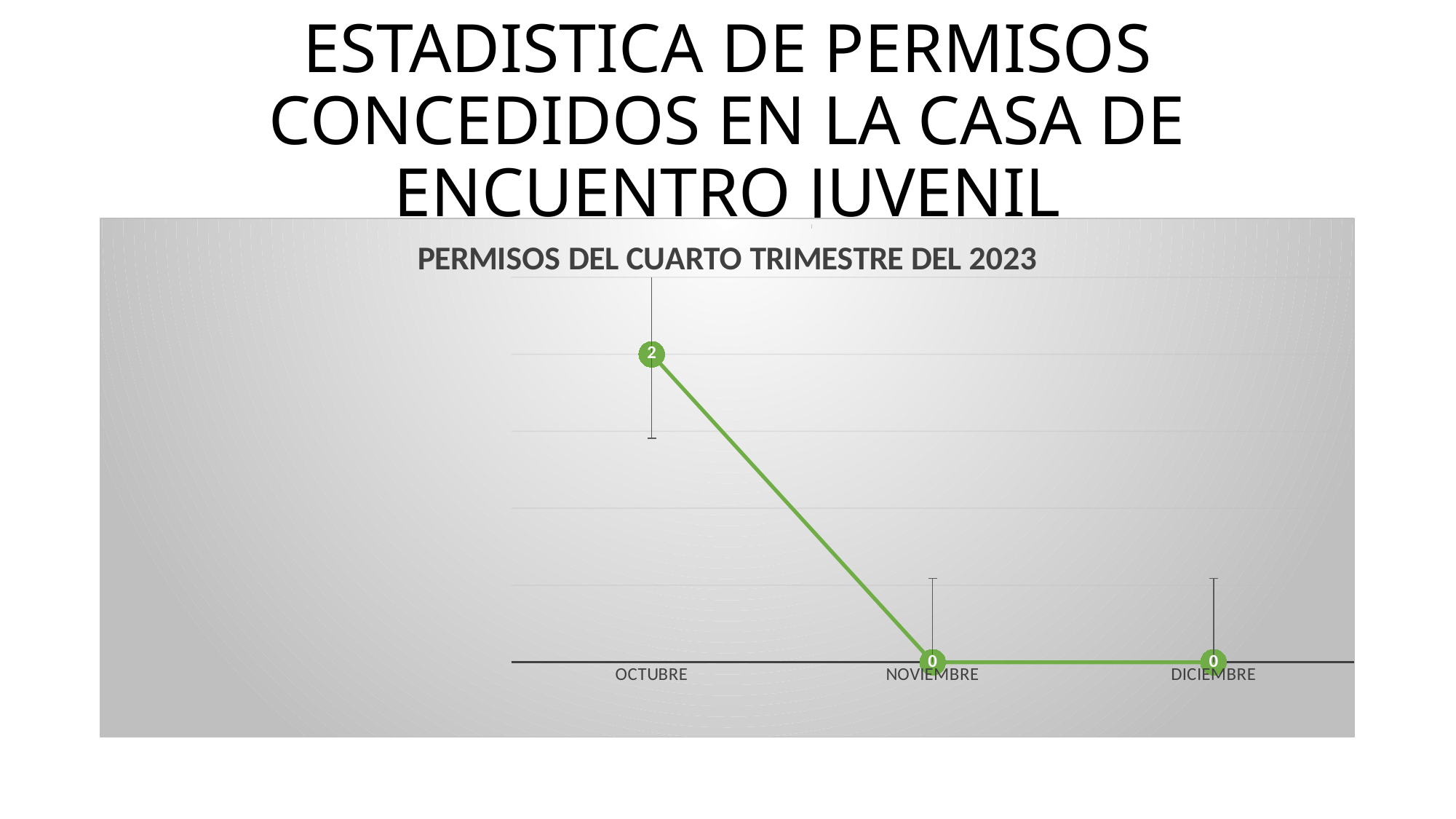
Which is larger, the value for OCTUBRE or the value for DICIEMBRE? OCTUBRE What is the value for NOVIEMBRE in the chart? 0 What kind of chart is shown on the slide? line chart What is the title of the chart? PERMISOS DEL CUARTO TRIMESTRE DEL 2023 What colour is the line in the chart? green Do the values rise or fall from OCTUBRE to DICIEMBRE? fall Which month has the highest value in the chart? OCTUBRE How many months are plotted in the chart? 3 What is the total of the values for OCTUBRE, NOVIEMBRE and DICIEMBRE? 2 What is the difference between the values for OCTUBRE and NOVIEMBRE? 2 What is the value for DICIEMBRE in the chart? 0 What is the value for OCTUBRE in the chart? 2